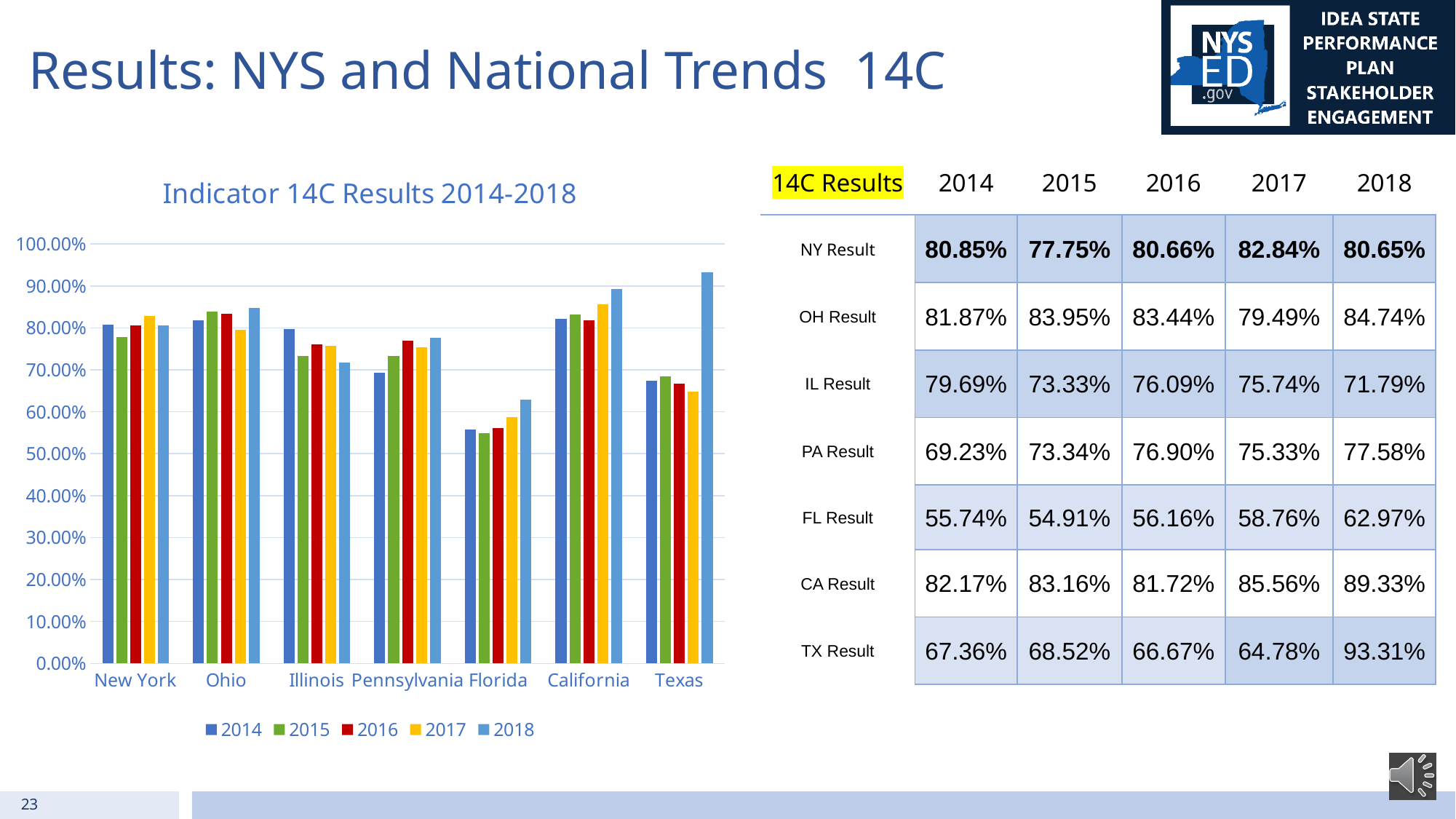
Is the 2015 value for Florida greater or less than 60.00%? less What is the difference between the 2018 values for California and Florida? 26.36% Do the values for Florida rise or fall from 2015 to 2018? rise What is the 2017 value for New York? 82.84% What is the 2018 value for Texas? 93.31% What type of chart is shown on the slide? bar chart Which state has the lowest 2014 value? Florida How many states are shown on the x axis of the chart? 7 How many series does the chart legend list? 5 Which is larger, the 2016 value for Ohio or the 2016 value for Illinois? Ohio What is the title of the chart? Indicator 14C Results 2014-2018 Which state has the highest 2018 value? Texas